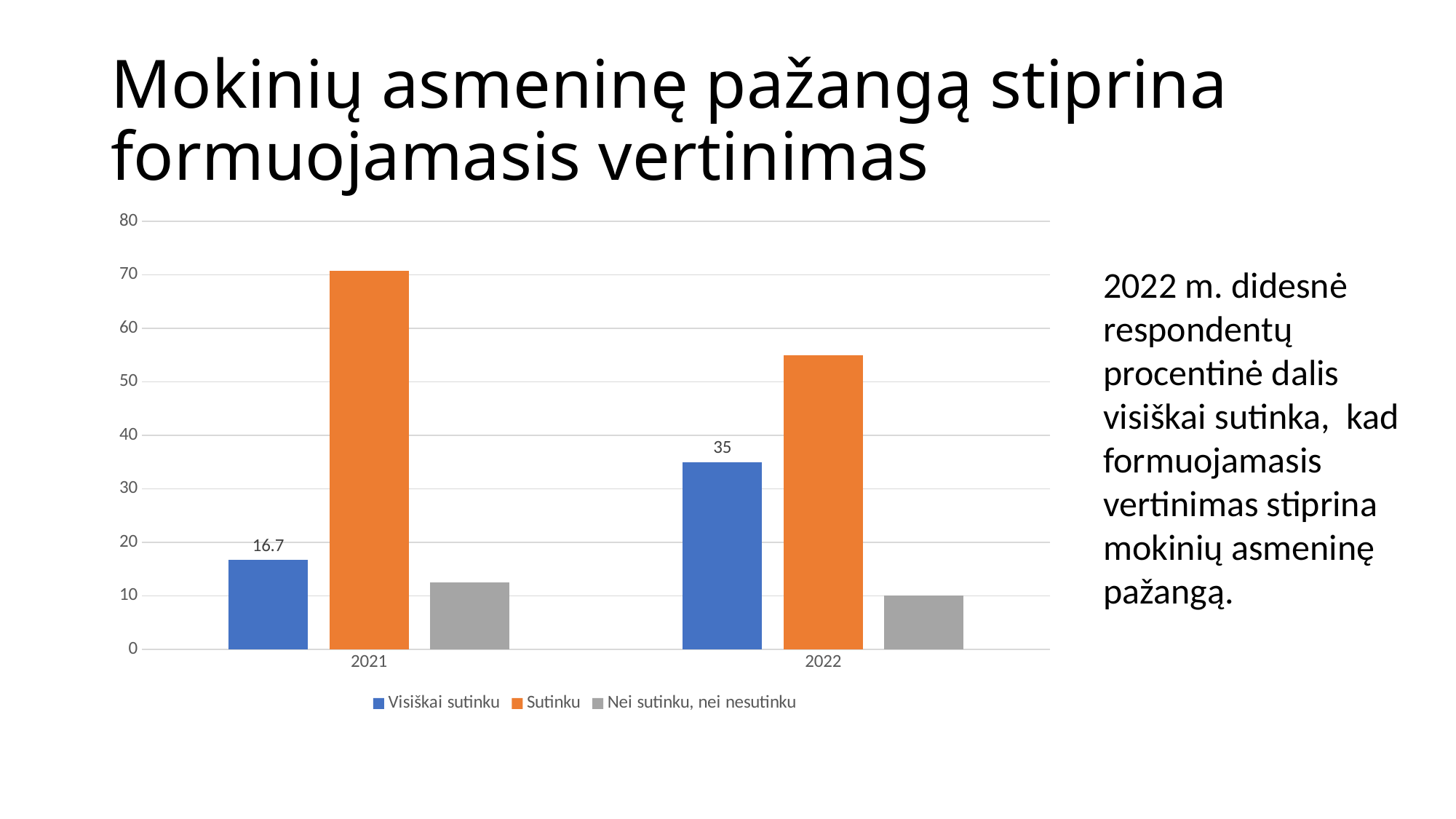
Is the Sutinku value larger in 2021 or in 2022? 2021 Which series has the lowest value in 2022? Nei sutinku, nei nesutinku How many series does the legend list? 3 By how much did the Visiškai sutinku value increase from 2021 to 2022? 18.3 What kind of chart is shown on the slide? bar chart Which series has the highest value in 2021? Sutinku What is the value for Visiškai sutinku in 2022? 35 Does the Visiškai sutinku value rise or fall from 2021 to 2022? rise How many categories (years) are shown on the x axis? 2 What is the value for Visiškai sutinku in 2021? 16.7 Is the value for Sutinku in 2021 greater or less than 60? greater Is the value for Nei sutinku, nei nesutinku in 2022 greater or less than 20? less